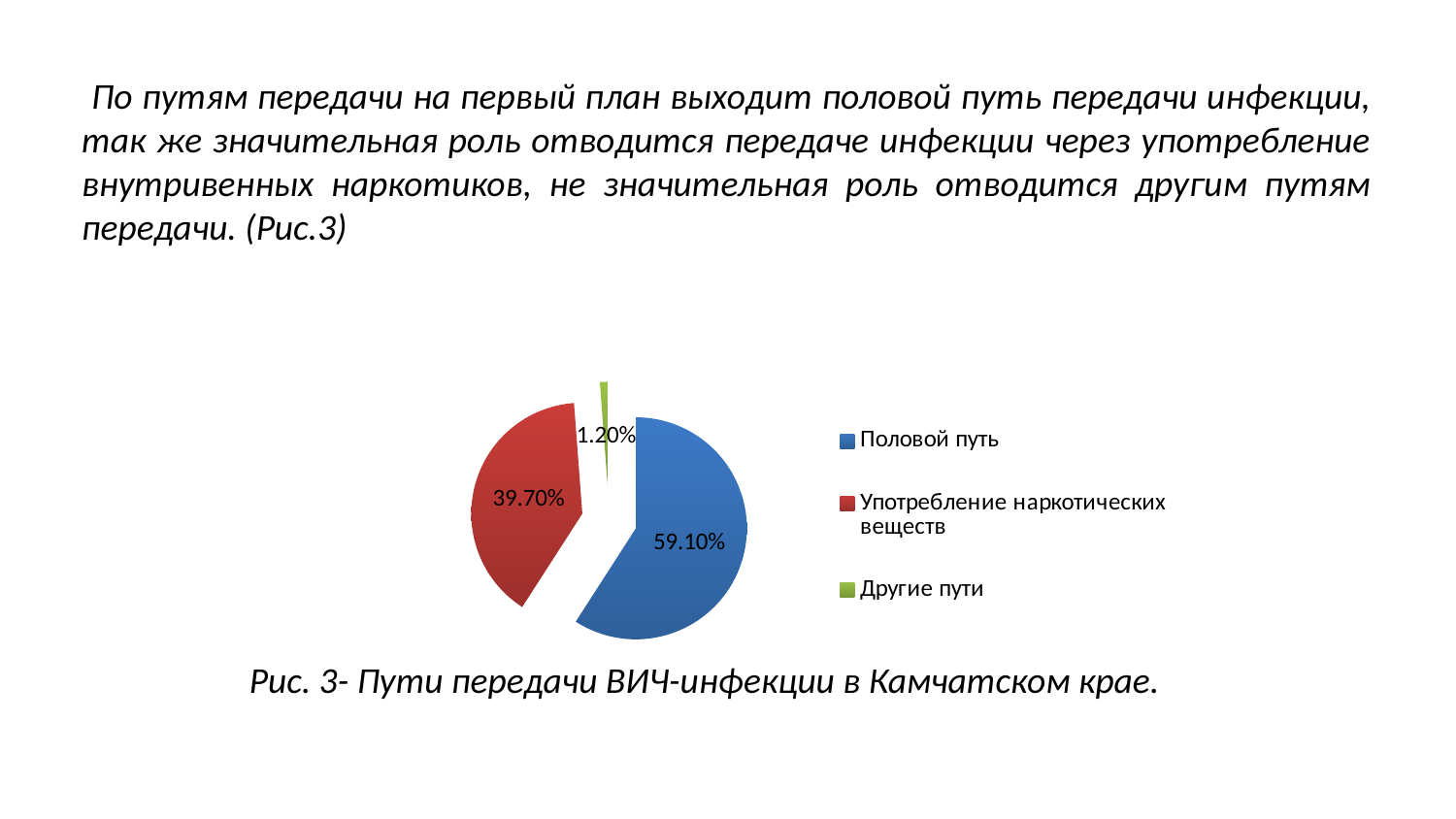
What colour is the slice for "Другие пути"? green What share of the pie does "Употребление наркотических веществ" account for? 39.70% Which is larger: the share of "Употребление наркотических веществ" or the share of "Другие пути"? Употребление наркотических веществ What type of chart is shown on the slide? pie chart What share of the pie does "Половой путь" account for? 59.10% How many entries does the legend list? 3 What is the caption of the chart (Рис. 3)? Пути передачи ВИЧ-инфекции в Камчатском крае. What share of the pie does "Другие пути" account for? 1.20% What is the difference between the shares of "Половой путь" and "Употребление наркотических веществ"? 19.40% Which category has the smallest slice of the pie? Другие пути How many categories does the pie chart show? 3 Which category has the largest slice of the pie? Половой путь